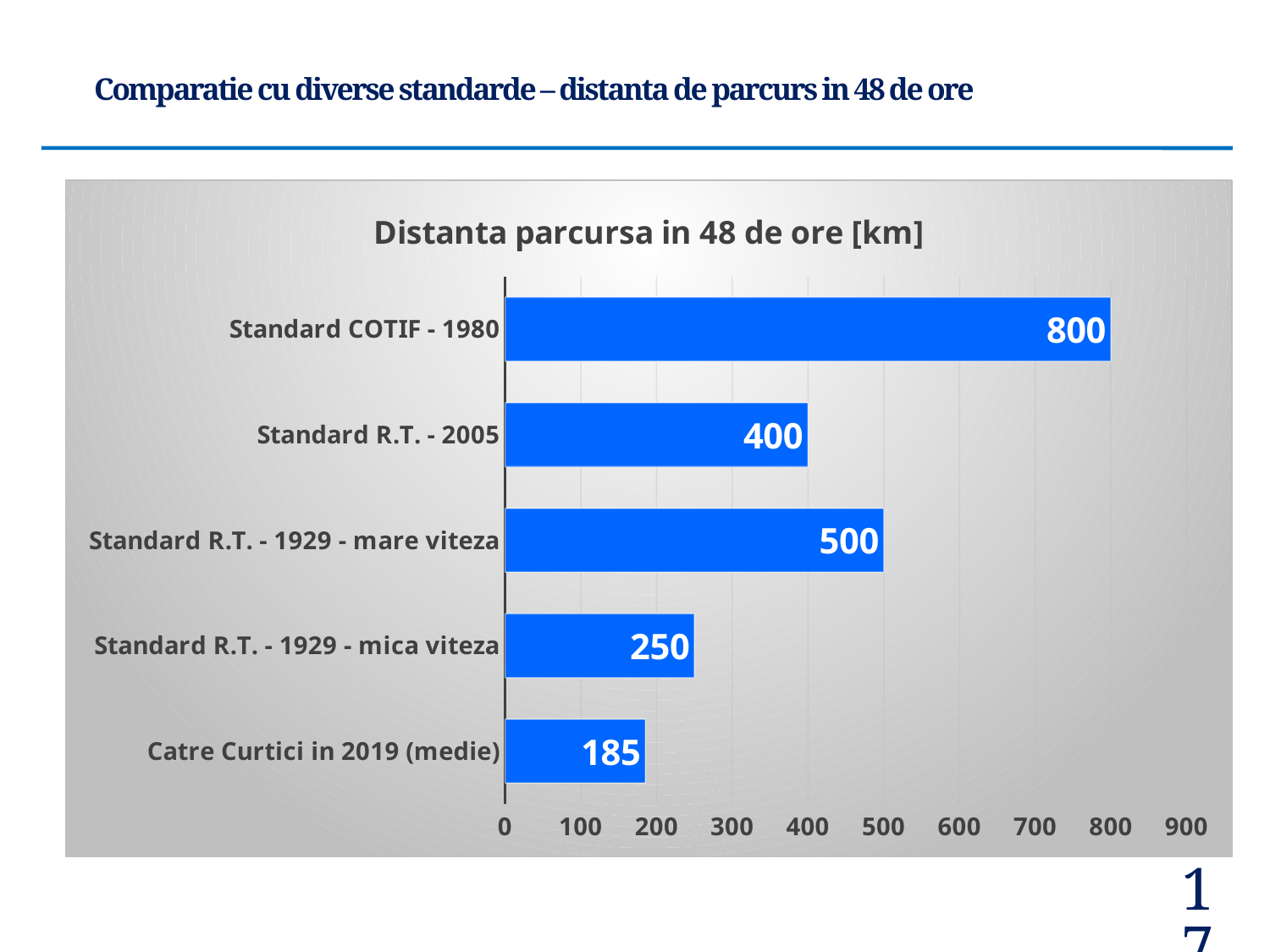
What is the value for Standard COTIF - 1980? 800 How many categories are shown in the chart? 5 Is the value for Standard R.T. - 1929 - mica viteza greater or less than 300? less Which is larger, Standard R.T. - 2005 or Standard R.T. - 1929 - mare viteza? Standard R.T. - 1929 - mare viteza What is the difference between Standard R.T. - 1929 - mare viteza and Catre Curtici in 2019 (medie)? 315 What is the value for Catre Curtici in 2019 (medie)? 185 What is the difference between Standard COTIF - 1980 and Standard R.T. - 2005? 400 What kind of chart is shown on the slide? bar chart Which category has the lowest value? Catre Curtici in 2019 (medie) What is the title of the chart? Distanta parcursa in 48 de ore [km] What is the value for Standard R.T. - 1929 - mica viteza? 250 Which category has the highest value? Standard COTIF - 1980